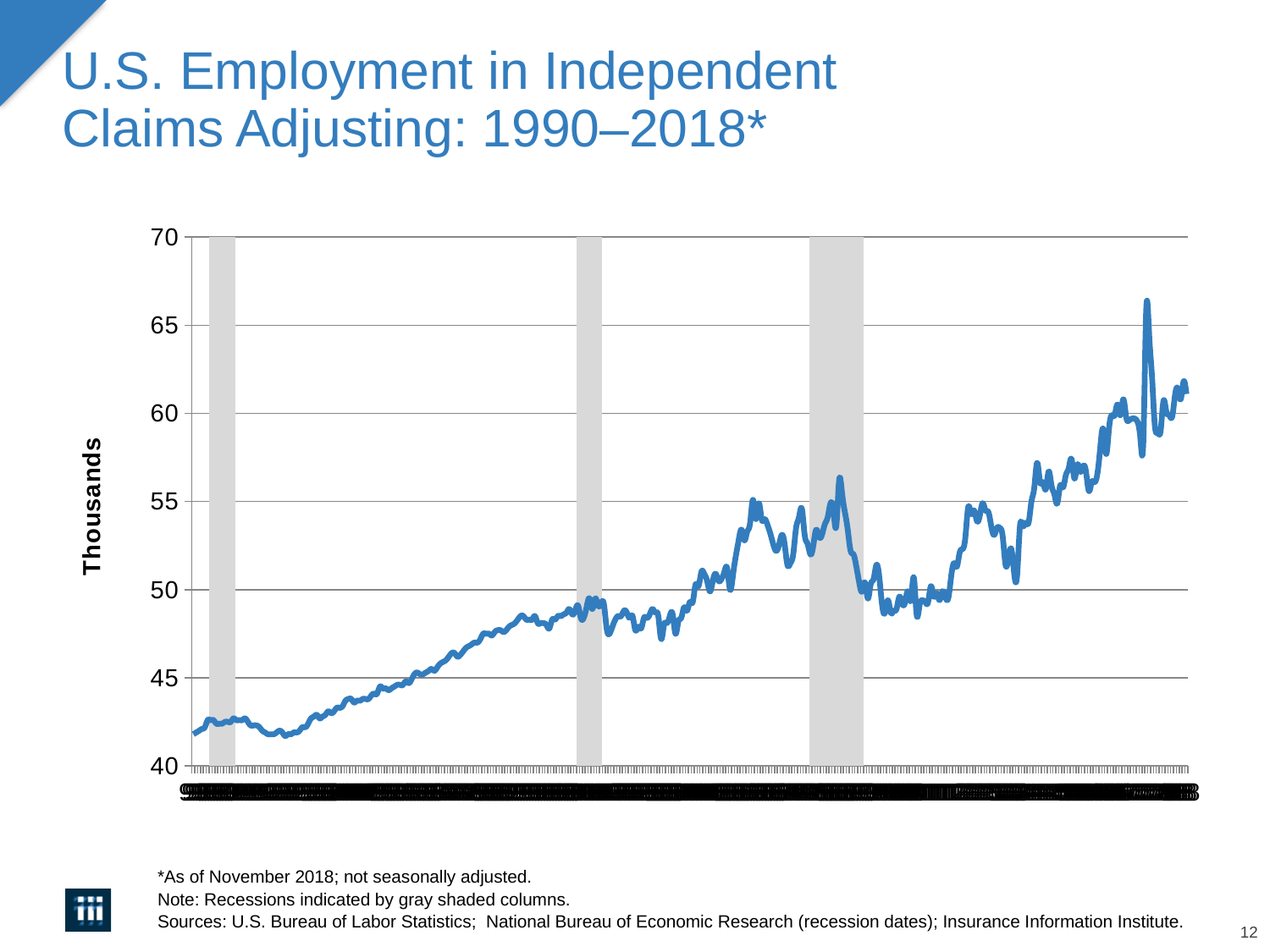
Is the highest point reached by the line greater or less than 65? greater Is the value at the start of the series (left end of the line) greater or less than 45? less Is the value at the end of the series (right end of the line) greater or less than 60? greater Which is larger, the value at the left end of the line or the value at the right end of the line? The right end How many data series are plotted on the chart? 1 What is the title of the chart? U.S. Employment in Independent Claims Adjusting: 1990–2018* What is the highest value shown on the vertical axis? 70 What is the label on the vertical axis of the chart? Thousands What kind of chart is shown on the slide? Line chart Overall, does the line rise or fall from the left of the chart to the right? Rise How many gray shaded recession columns appear on the chart? 3